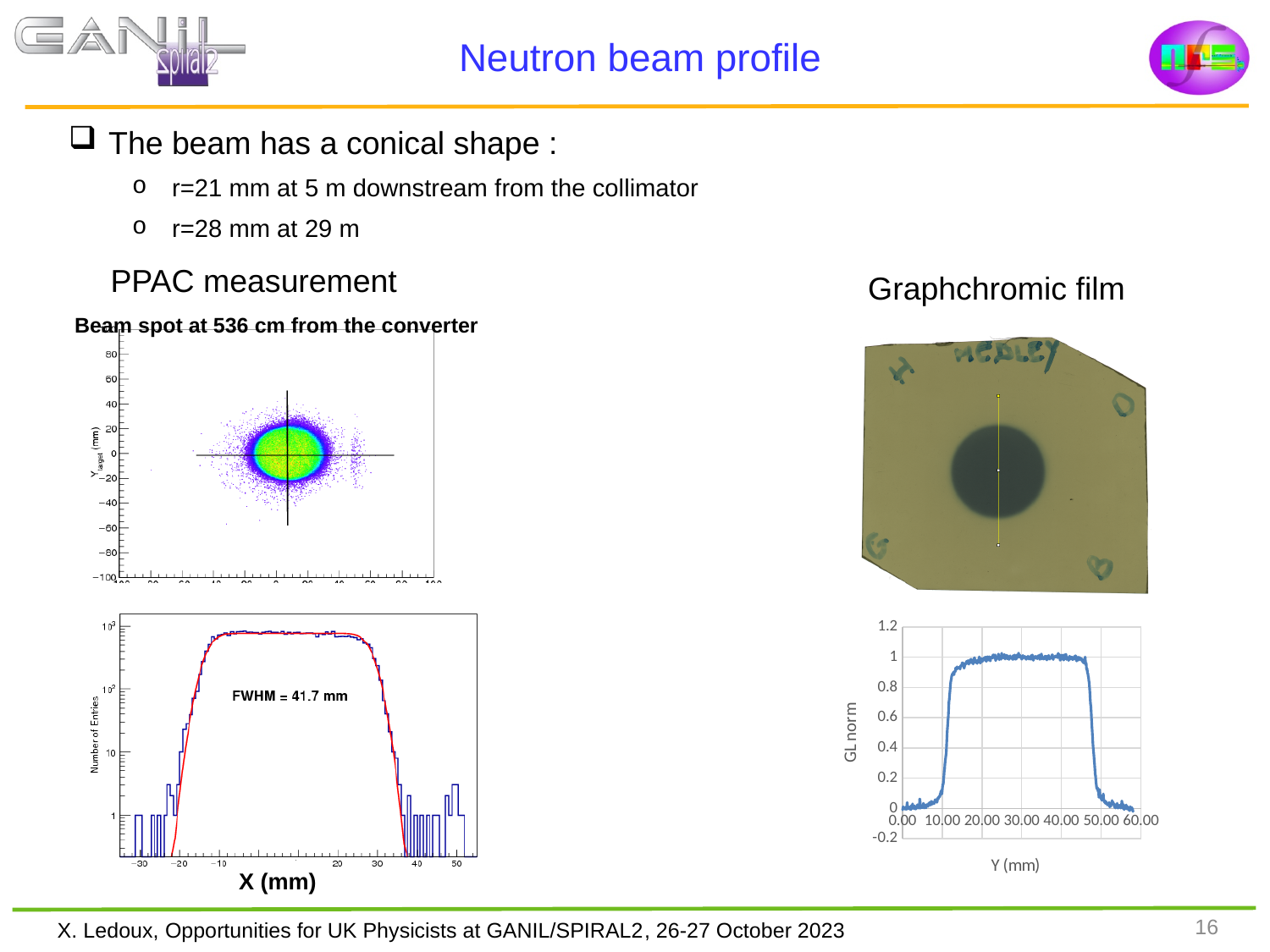
What is the title of the 2D beam spot chart on the left of the slide? Beam spot at 536 cm from the converter On the bottom-right chart of GL norm versus Y (mm), is the value at Y = 30.00 mm greater or less than 0.8? greater On the bottom-right chart of GL norm versus Y (mm), what is the largest tick value shown on the horizontal axis? 60.00 On the bottom-right chart of GL norm versus Y (mm), what is the highest tick value shown on the vertical axis? 1.2 On the bottom-right chart of GL norm versus Y (mm), what kind of chart is it? line chart On the bottom-right chart of GL norm versus Y (mm), does the curve rise or fall between Y = 45.00 mm and Y = 50.00 mm? fall On the bottom-right chart of GL norm versus Y (mm), is the value at Y = 55.00 mm greater or less than 0.4? less On the bottom-right chart of GL norm versus Y (mm), does the curve rise or fall between Y = 10.00 mm and Y = 15.00 mm? rise What is the label of the horizontal axis on the histogram below the beam spot chart? X (mm) On the histogram of Number of Entries versus X (mm), what FWHM value is printed on the chart? 41.7 mm On the bottom-right chart of GL norm versus Y (mm), is the value at Y = 5.00 mm greater or less than 0.2? less